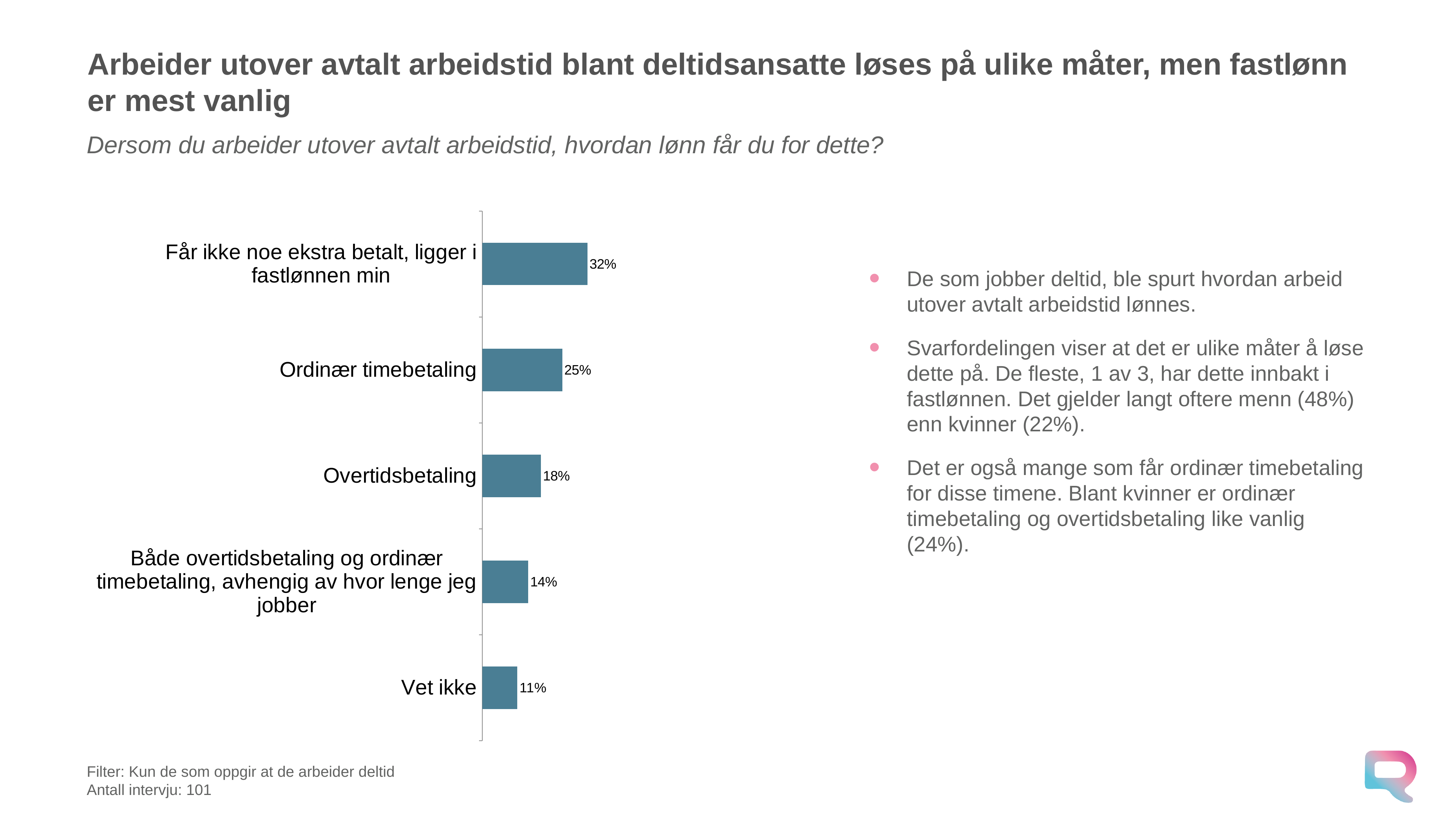
What is the difference between "Får ikke noe ekstra betalt, ligger i fastlønnen min" and "Ordinær timebetaling"? 7% How many categories are shown in the chart? 5 Which is larger, "Overtidsbetaling" or "Ordinær timebetaling"? Ordinær timebetaling What is the value for "Både overtidsbetaling og ordinær timebetaling, avhengig av hvor lenge jeg jobber"? 14% What is the number of interviews (Antall intervju) stated below the chart? 101 What is the value for "Overtidsbetaling"? 18% What is the value for "Ordinær timebetaling"? 25% What is the difference between "Overtidsbetaling" and "Vet ikke"? 7% Which category has the highest value? Får ikke noe ekstra betalt, ligger i fastlønnen min What is the value for "Vet ikke"? 11% Which category has the lowest value? Vet ikke What kind of chart is shown on the slide? Bar chart